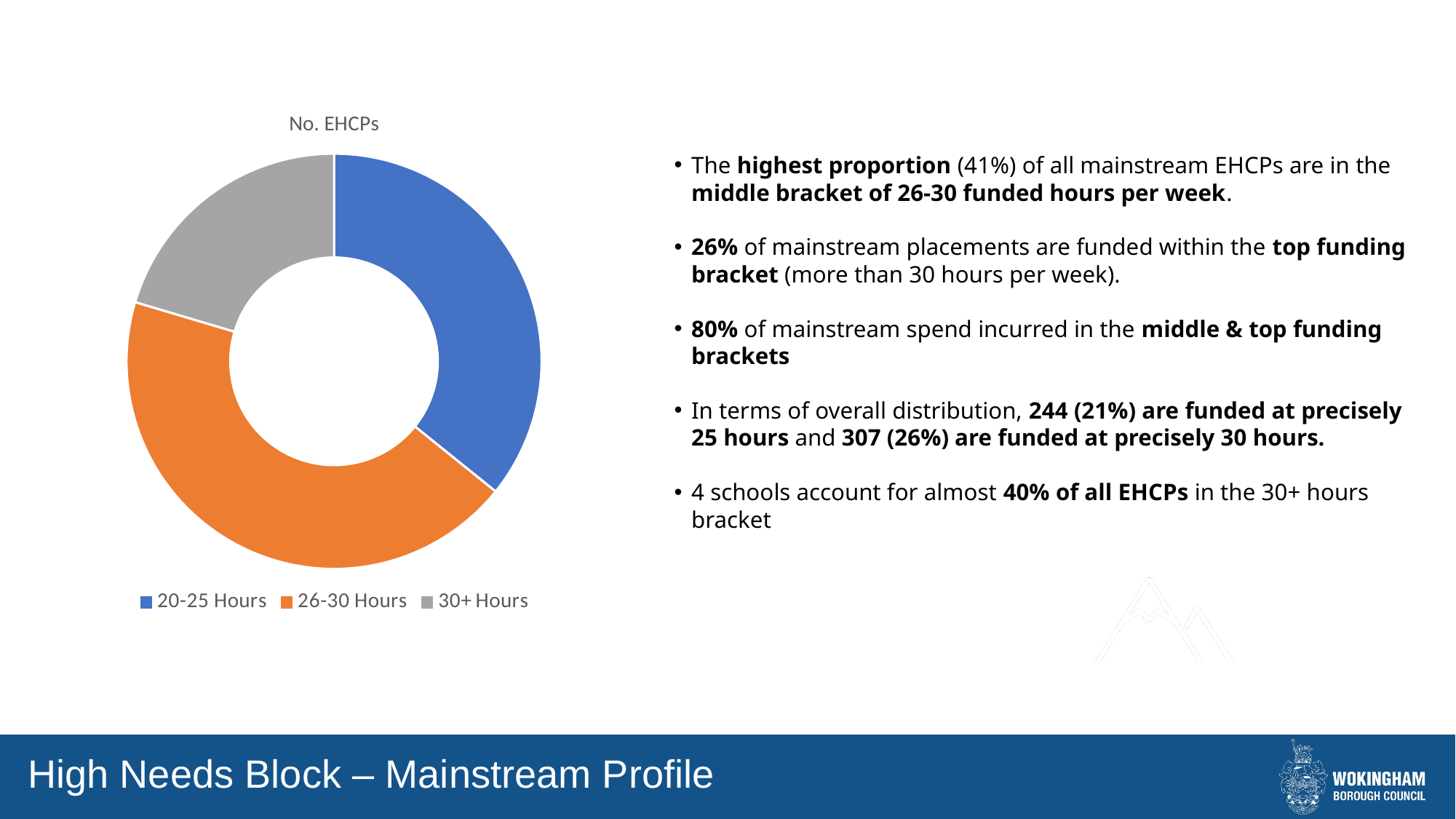
Which slice is larger, 20-25 Hours or 30+ Hours? 20-25 Hours What kind of chart is shown on the slide? Pie chart (doughnut) Which slice is larger, 26-30 Hours or 20-25 Hours? 26-30 Hours How many entries does the chart legend list? 3 According to the slide, what share of mainstream placements falls in the 30+ Hours bracket? 26% How many categories does the chart show? 3 Which category has the largest slice of the chart? 26-30 Hours According to the slide, what share of mainstream EHCPs falls in the 26-30 Hours bracket? 41% What is the title of the chart? No. EHCPs Which category has the smallest slice of the chart? 30+ Hours Which colour represents the 26-30 Hours category in the chart? Orange